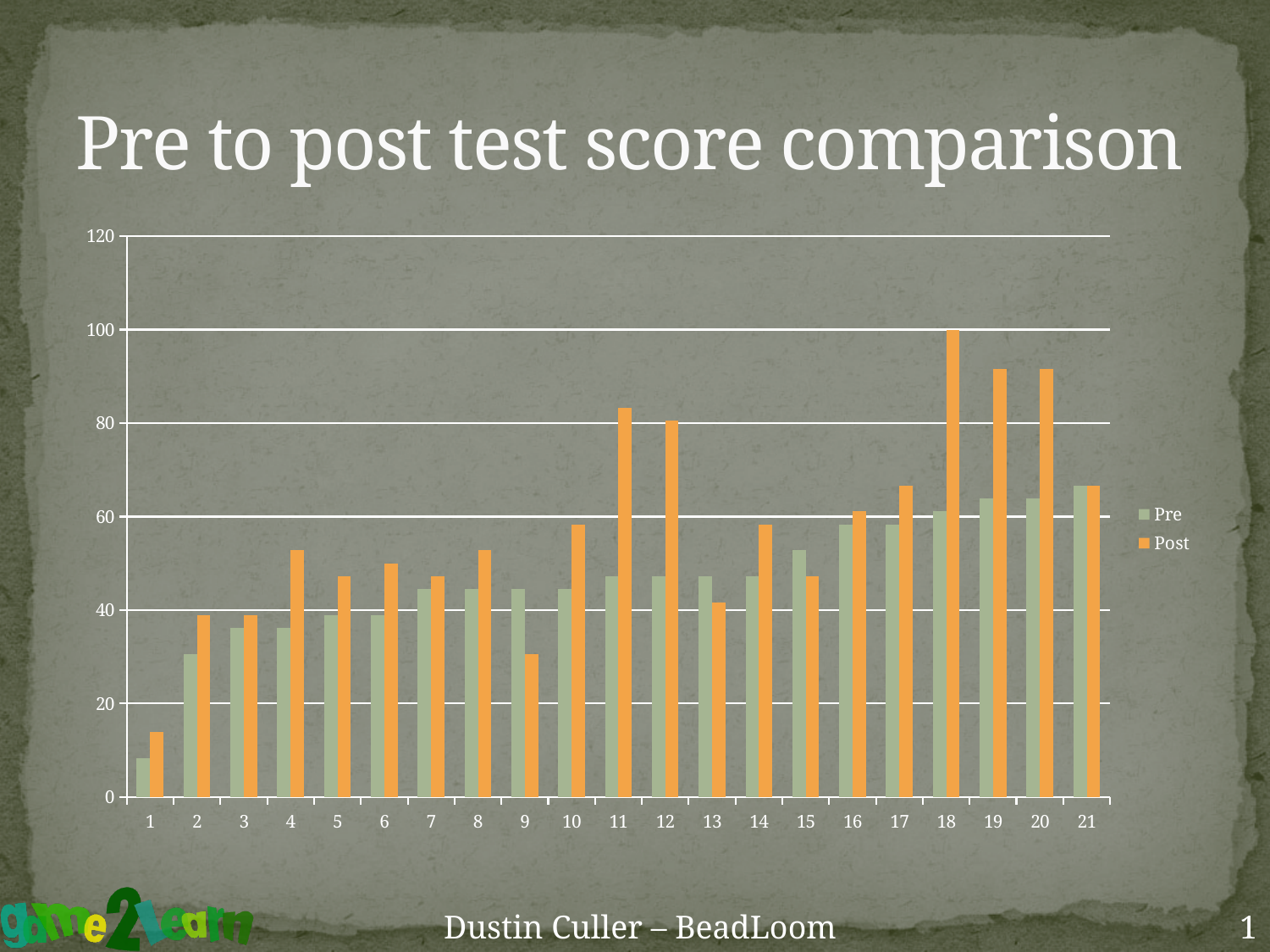
Which category has the lowest Post value? 1 What is the title of the chart? Pre to post test score comparison Is the Pre value for category 9 greater or less than 60? less How many categories are shown along the x axis? 21 Do the Pre values generally rise or fall from category 1 to category 21? rise What kind of chart is shown on the slide? bar chart For category 9, which is larger, the Pre value or the Post value? Pre Which category has the lowest Pre value? 1 Is the Post value for category 11 greater or less than 80? greater How many series does the legend list? 2 What is the Post value for category 18? 100 Which category has the highest Post value? 18